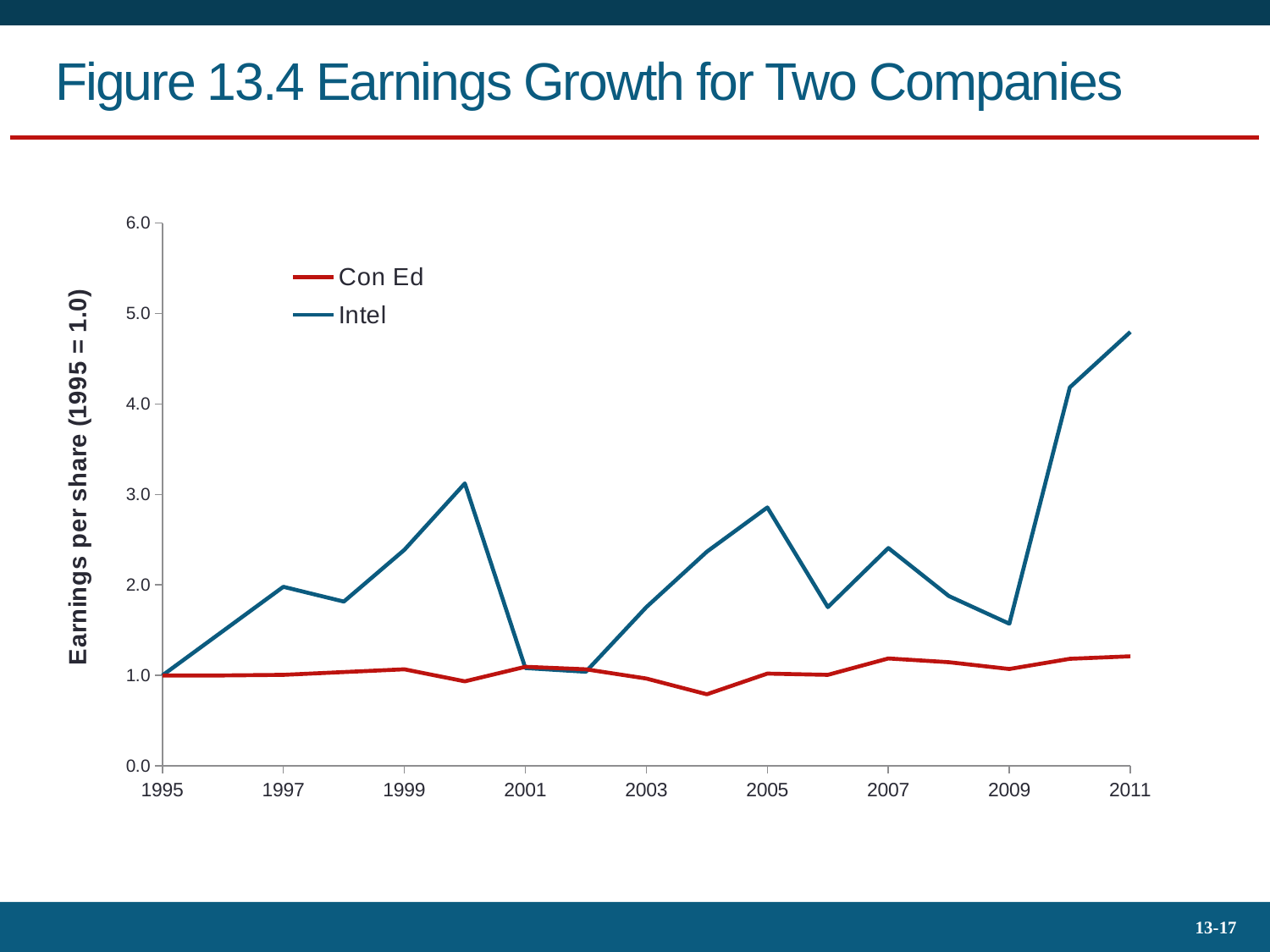
Is the value for Con Ed in 2004 greater or less than 1.0? less Is the value for Intel in 2011 greater or less than 4.0? greater In which year does the Intel line reach its highest value? 2011 What colour is the Intel line in the legend? blue What is the value for Intel in 1995? 1.0 What kind of chart is shown on the slide? line chart What is the value for Con Ed in 1995? 1.0 Which series has the larger value in 2011, Con Ed or Intel? Intel In which year does the Con Ed line reach its lowest value? 2004 Is the value for Intel in 2005 greater or less than 2.0? greater How many series does the legend list? 2